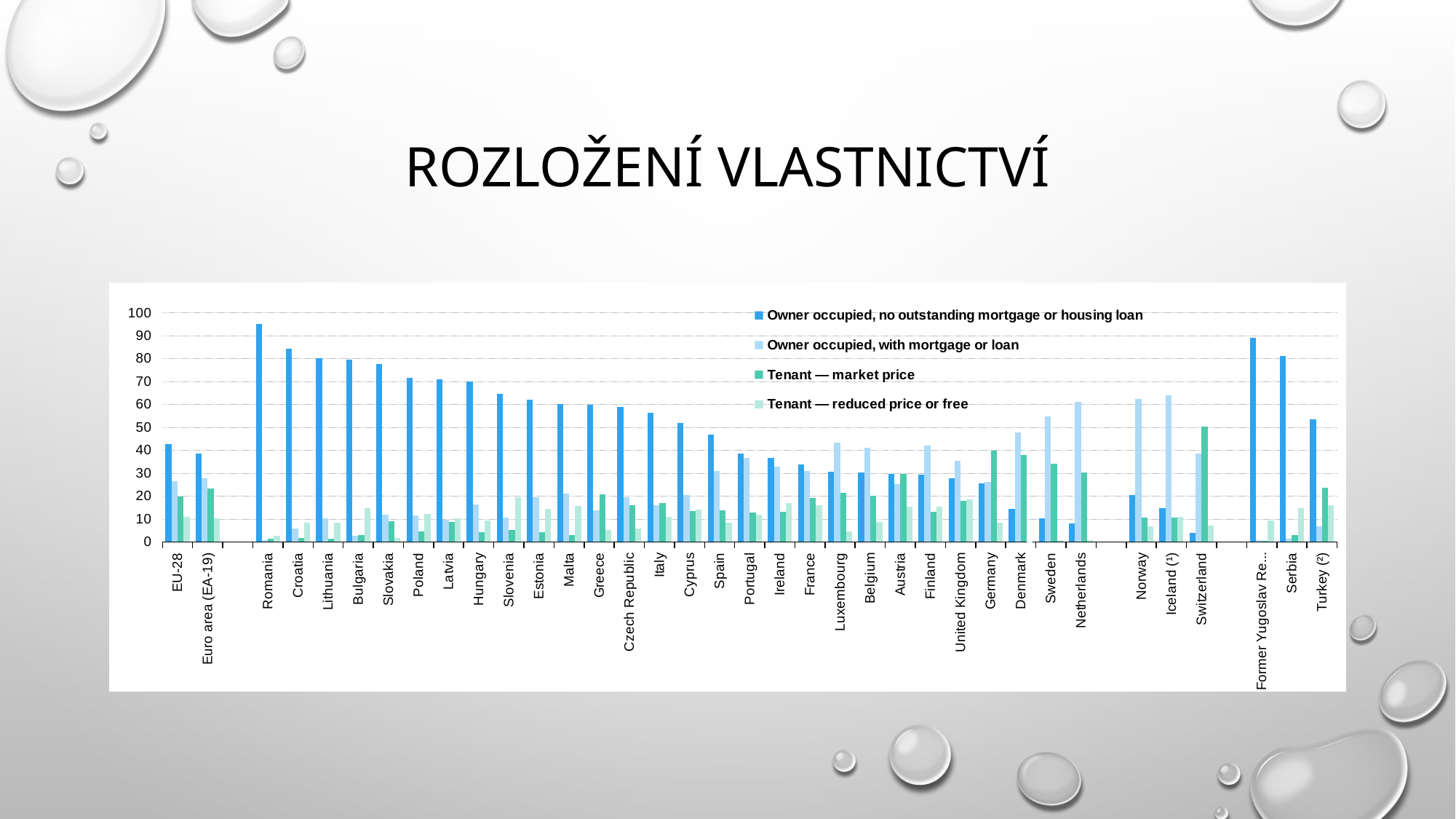
Which country has the highest value for 'Owner occupied, no outstanding mortgage or housing loan'? Romania Is the 'Owner occupied, no outstanding mortgage or housing loan' value for Spain greater or less than 50? less Which country has a larger 'Tenant — market price' value: Switzerland or Germany? Switzerland What is the title of the slide? ROZLOŽENÍ VLASTNICTVÍ Is the 'Owner occupied, with mortgage or loan' value for Sweden greater or less than 50? greater Do the 'Owner occupied, no outstanding mortgage or housing loan' values generally rise or fall from Romania to Germany along the x axis? fall What kind of chart is shown on the slide? bar chart How many series does the legend list? 4 Which country has the highest value for 'Tenant — market price'? Switzerland Which is larger for Denmark: 'Owner occupied, with mortgage or loan' or 'Owner occupied, no outstanding mortgage or housing loan'? Owner occupied, with mortgage or loan Is the 'Owner occupied, no outstanding mortgage or housing loan' value for Romania greater or less than 90? greater